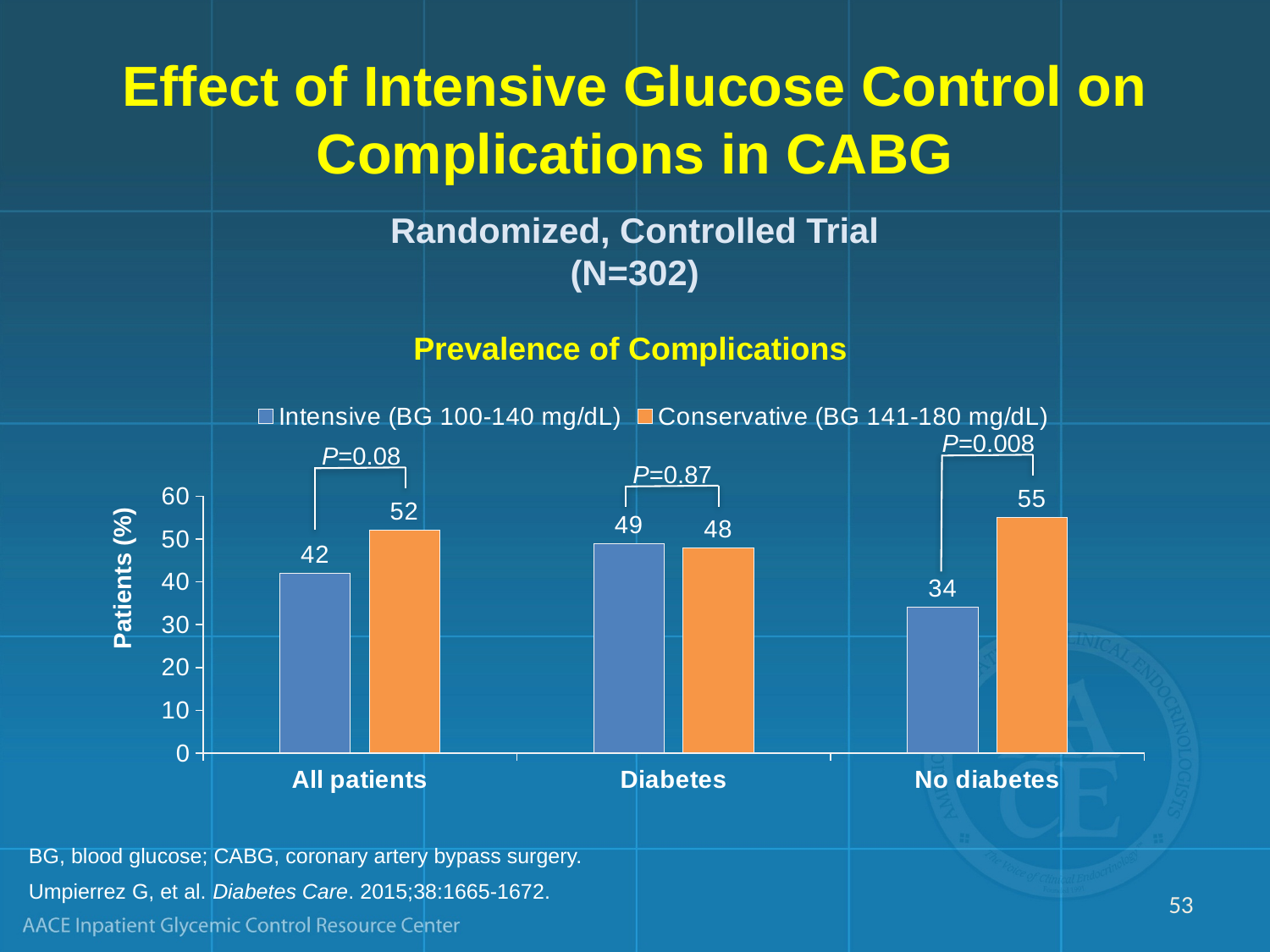
What is the label of the y axis? Patients (%) What is the difference between the Conservative and Intensive values in the No diabetes category? 21 What is the value for the Conservative (BG 141-180 mg/dL) series in the No diabetes category? 55 What is the difference between the Conservative and Intensive values in the All patients category? 10 What kind of chart is shown on the slide? Bar chart What is the value for the Intensive (BG 100-140 mg/dL) series in the Diabetes category? 49 Which category has the lowest value for the Intensive (BG 100-140 mg/dL) series? No diabetes Which category has the highest value for the Conservative (BG 141-180 mg/dL) series? No diabetes In the All patients category, which series has the larger value, Intensive or Conservative? Conservative (BG 141-180 mg/dL) How many series does the legend list? 2 How many categories are shown on the x axis? 3 What is the value for the Intensive (BG 100-140 mg/dL) series in the All patients category? 42